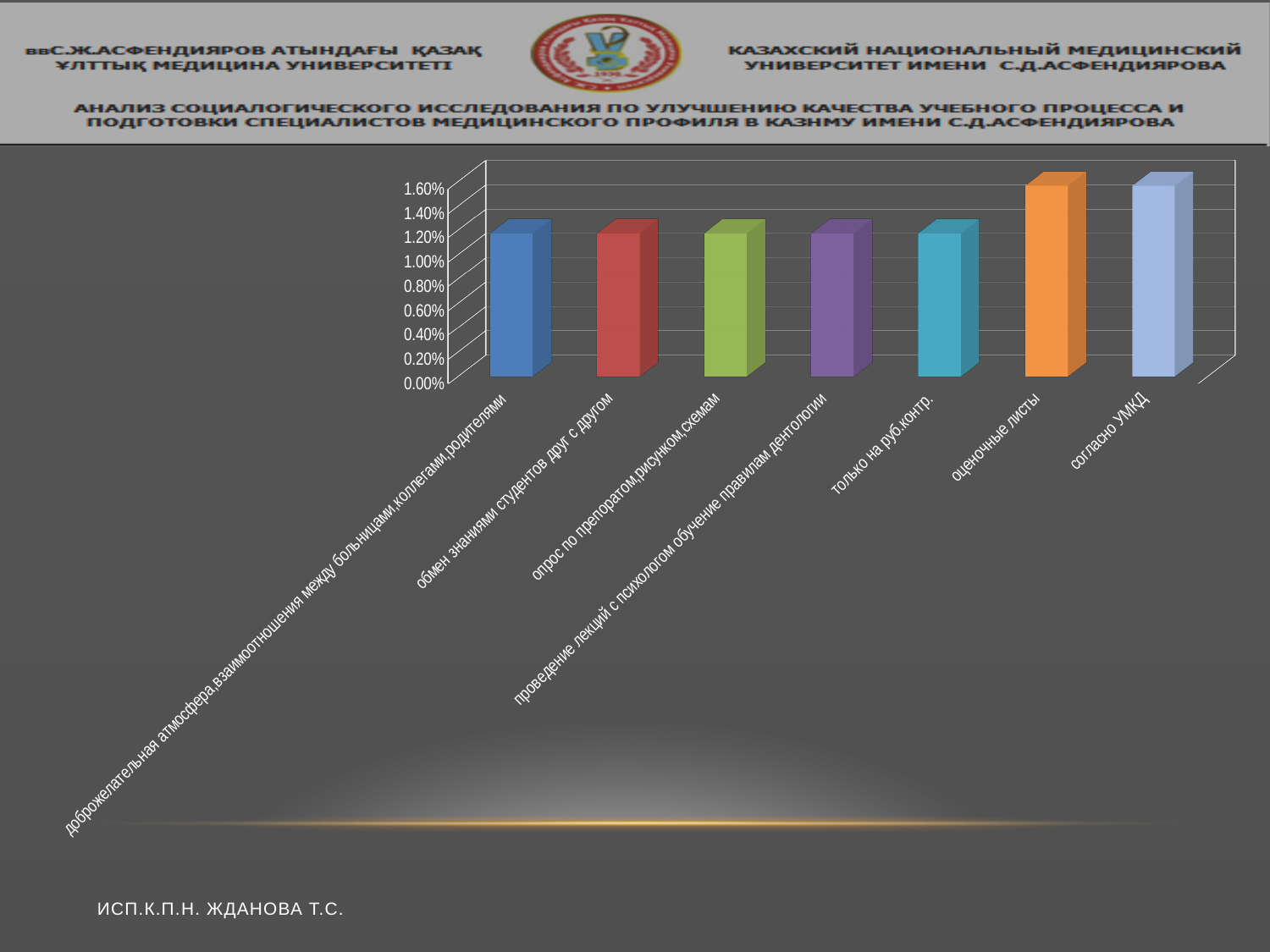
Is the value for "только на руб.контр." greater or less than 1.40%? less Which is larger, the value for "согласно УМКД" or the value for "проведение лекций с психологом обучение правилам дентологии"? согласно УМКД Is the value for "оценочные листы" greater or less than 1.40%? greater Which is larger, the value for "оценочные листы" or the value for "только на руб.контр."? оценочные листы How many categories (bars) does the chart show? 7 What colour is the bar for "оценочные листы"? orange Is the value for "согласно УМКД" greater or less than 1.40%? greater What is the highest value shown on the vertical axis? 1.60% What kind of chart is shown on the slide? bar chart